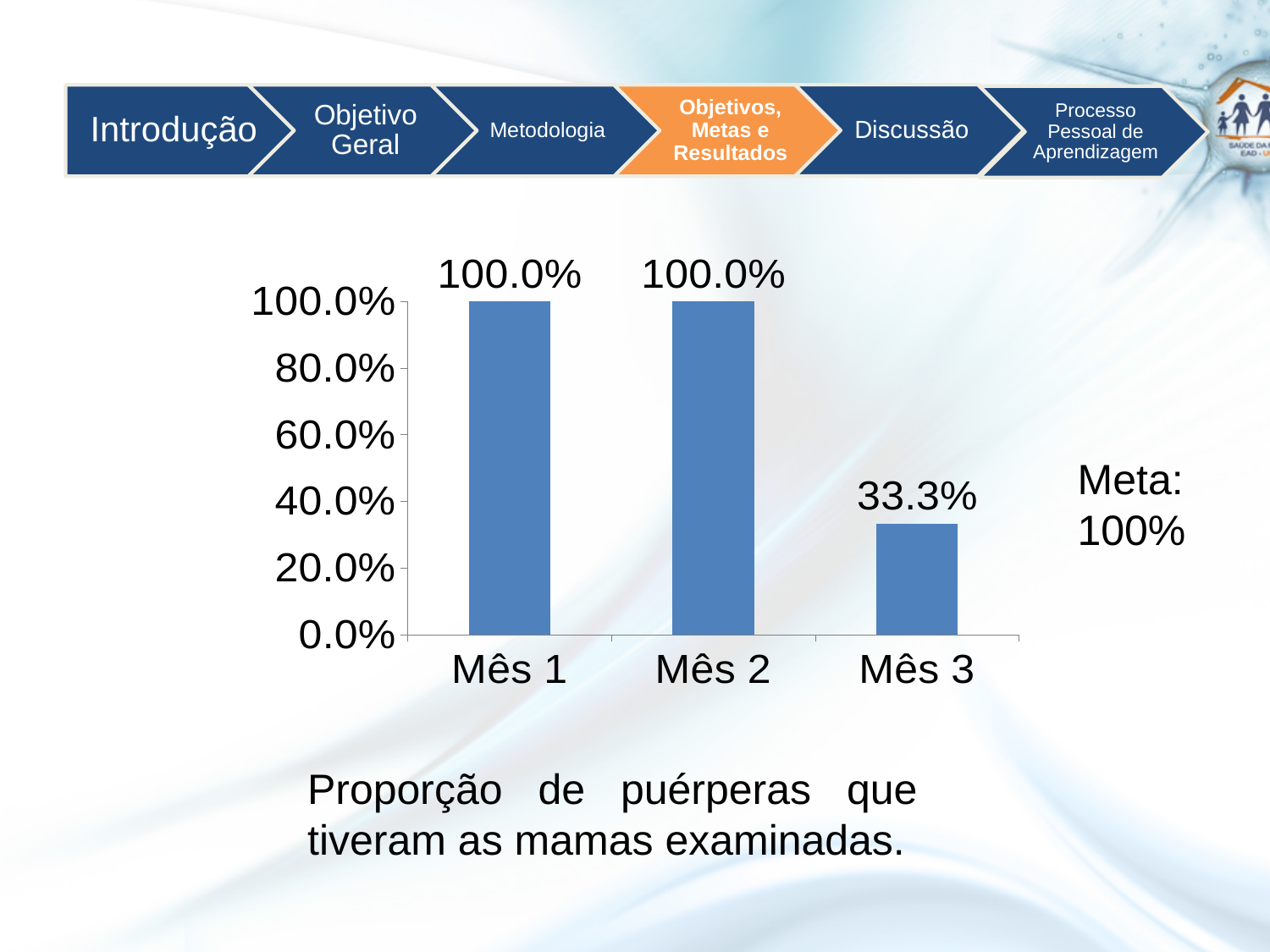
What is the difference between the values for Mês 2 and Mês 3? 66.7% Is the value for Mês 3 greater or less than 40.0%? less What is the value for Mês 2? 100.0% What kind of chart is shown on the slide? bar chart What is the caption below the chart? Proporção de puérperas que tiveram as mamas examinadas. What is the value for Mês 3? 33.3% How many months are shown on the x axis? 3 Which month has the lowest value? Mês 3 What target (Meta) is stated next to the chart? 100% Do the values rise or fall from Mês 2 to Mês 3? fall Which is larger, the value for Mês 1 or the value for Mês 3? Mês 1 What is the value for Mês 1? 100.0%